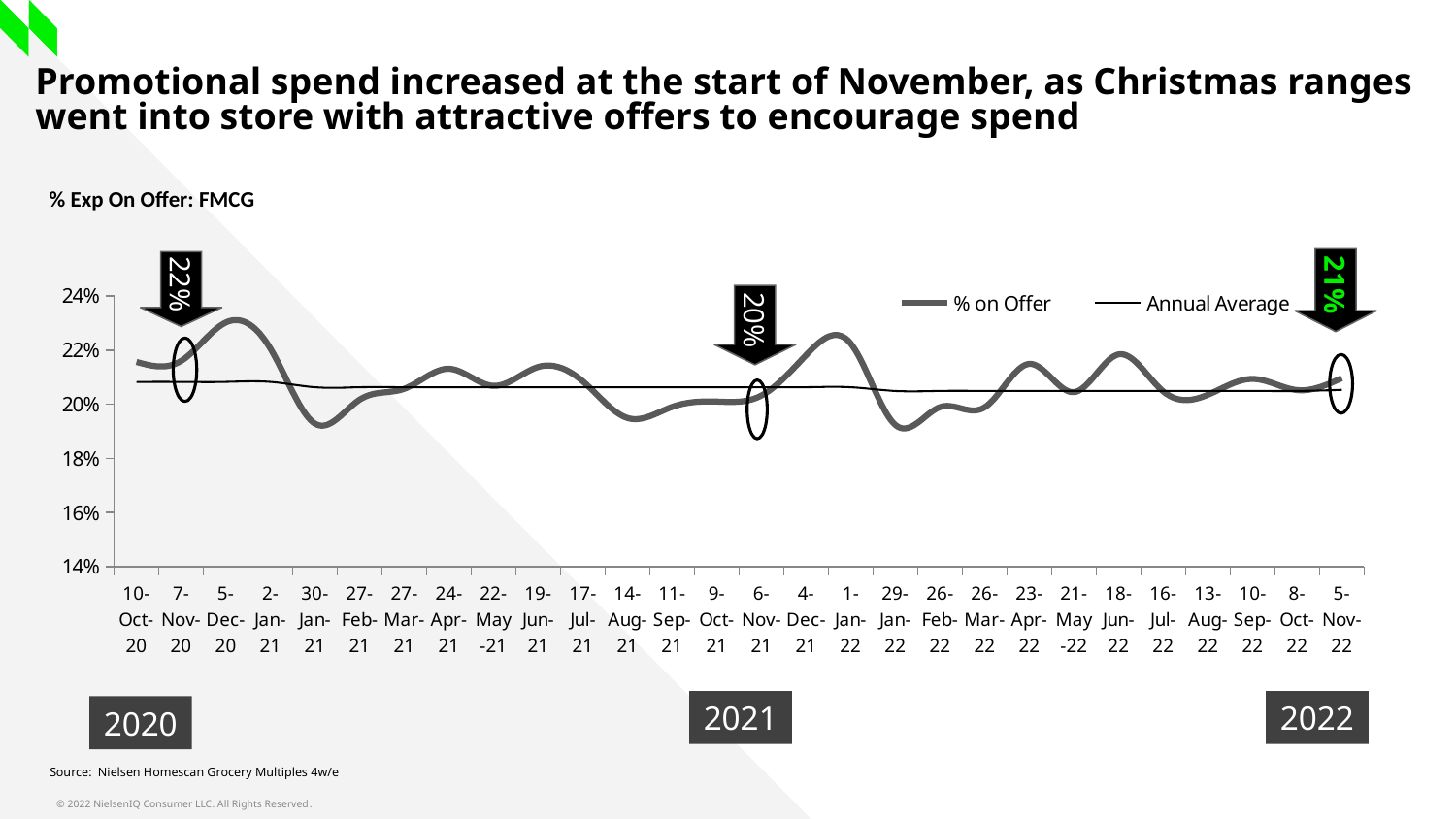
What are the two series named in the chart legend? % on Offer and Annual Average What is the title of the chart? % Exp On Offer: FMCG Is the % on Offer value for 30-Jan-21 greater or less than 20%? less What is the % on Offer value highlighted for 7-Nov-20? 22% What is the difference between the highlighted % on Offer values for 7-Nov-20 and 6-Nov-21? 2 percentage points What is the % on Offer value highlighted for 5-Nov-22? 21% Is the % on Offer value for 5-Dec-20 greater or less than 22%? greater What is the % on Offer value highlighted for 6-Nov-21? 20% What kind of chart is shown on the slide? line chart How many dates are labelled along the x axis of the chart? 28 How many series does the chart legend list? 2 Which is larger, the highlighted % on Offer value for 7-Nov-20 or for 6-Nov-21? 7-Nov-20